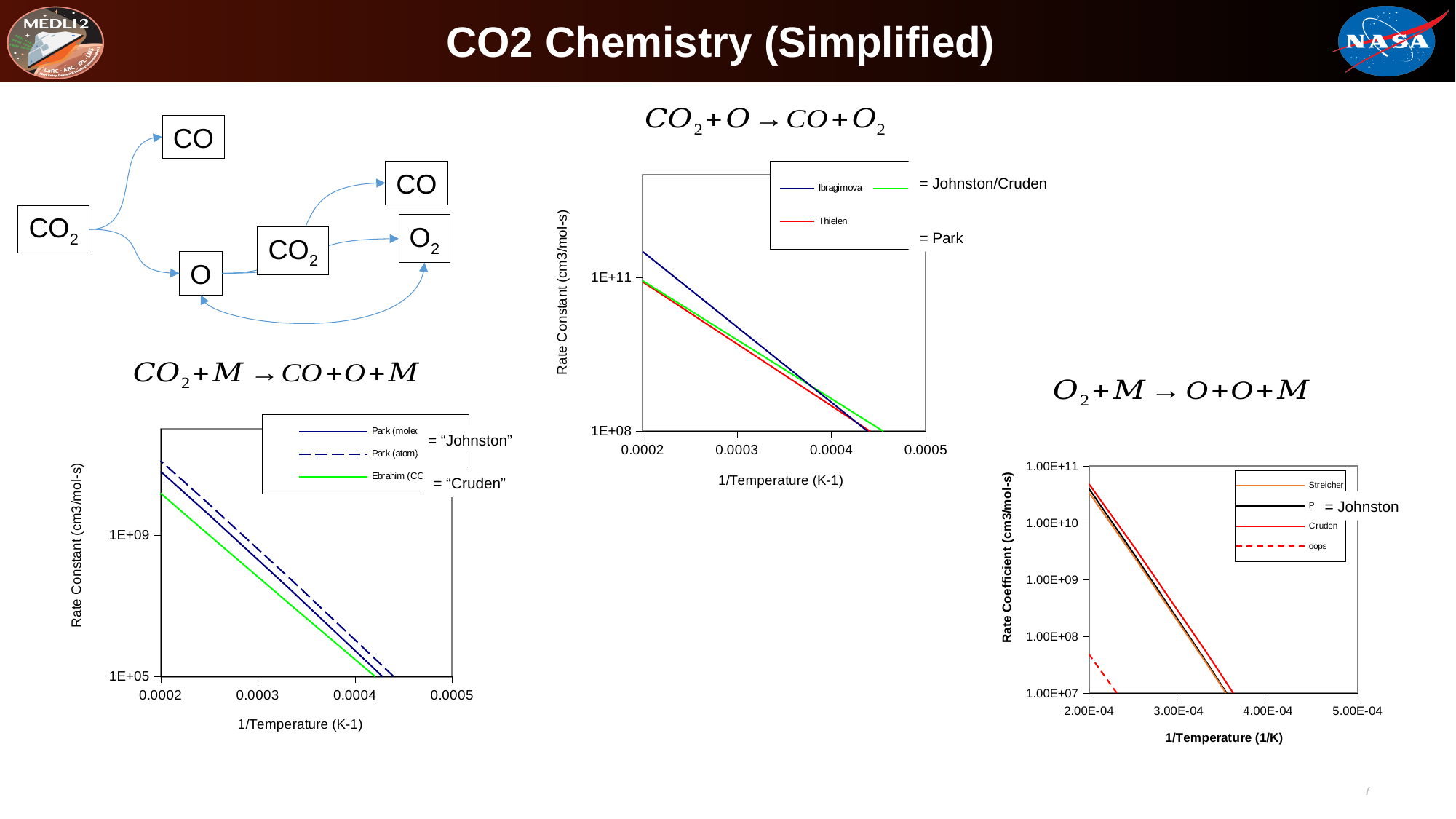
In the CO2+M → CO+O+M chart, is the Park (atom) value at 0.0002 greater or less than 1E+09? greater What is the x-axis label of the CO2+M → CO+O+M chart? 1/Temperature (K-1) In the CO2+M → CO+O+M chart, do the rate constants rise or fall as 1/Temperature increases? fall In the CO2+O → CO+O2 chart, do the rate constants rise or fall as 1/Temperature increases? fall What kind of chart is the CO2+M → CO+O+M chart at the bottom left? line chart How many series does the legend of the CO2+M → CO+O+M chart list? 3 In the O2+M → O+O+M chart, is the Cruden value at 2.00E-04 greater or less than 1.00E+11? less In the O2+M → O+O+M chart, is the 'oops' value at 2.00E-04 greater or less than 1.00E+08? less What kind of chart is the CO2+O → CO+O2 chart at the top middle? line chart How many series does the legend of the O2+M → O+O+M chart at the bottom right list? 4 What is the y-axis label of the O2+M → O+O+M chart? Rate Coefficient (cm3/mol-s)